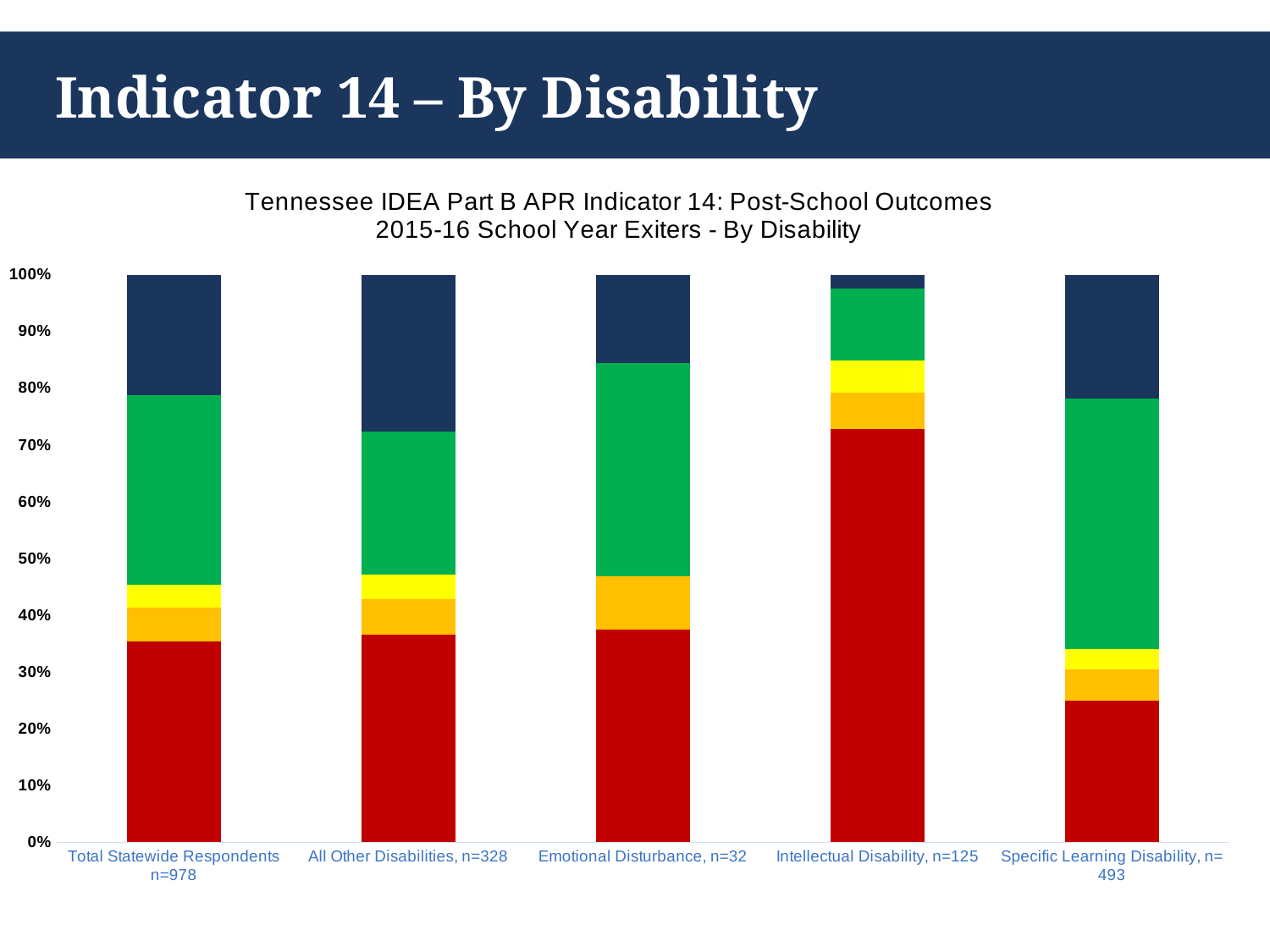
Which category has the largest red (bottom) segment? Intellectual Disability, n=125 Which category has the smallest red (bottom) segment? Specific Learning Disability, n=493 Which category has the largest dark blue (top) segment? All Other Disabilities, n=328 Is the red segment for Intellectual Disability greater or less than 70%? greater What is the total height of each stacked bar? 100% What is the sample size (n) shown for Total Statewide Respondents? n=978 What is the title of the chart? Tennessee IDEA Part B APR Indicator 14: Post-School Outcomes 2015-16 School Year Exiters - By Disability How many disability categories are shown along the x axis? 5 What kind of chart is shown on the slide? Stacked bar chart What is the sample size (n) shown for Specific Learning Disability? n=493 What is the sample size (n) shown for Emotional Disturbance? n=32 Is the red segment for Specific Learning Disability greater or less than 30%? less